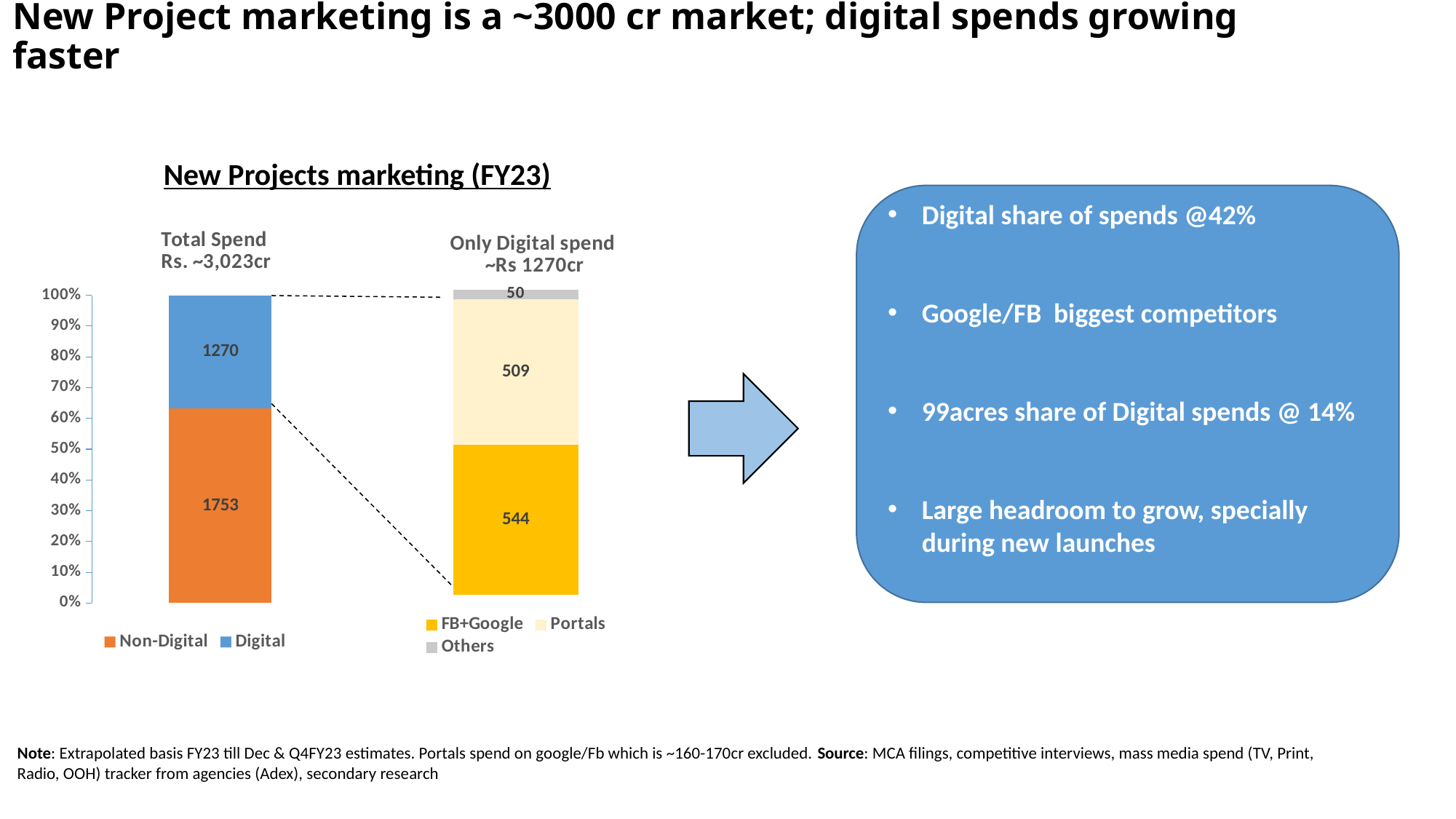
In the New Projects marketing (FY23) chart, what is the value labelled for Portals in the Only Digital spend bar? 509 In the New Projects marketing (FY23) chart, what is the value labelled for Others in the Only Digital spend bar? 50 In the New Projects marketing (FY23) chart, what is the total of the three segments in the Only Digital spend bar? 1103 In the New Projects marketing (FY23) chart, what is the difference between the Non-Digital and Digital values in the Total Spend bar? 483 In the New Projects marketing (FY23) chart, what is the value labelled for Non-Digital in the Total Spend bar? 1753 In the New Projects marketing (FY23) chart, which is larger in the Total Spend bar: Non-Digital or Digital? Non-Digital In the New Projects marketing (FY23) chart, which segment of the Only Digital spend bar has the largest value? FB+Google In the New Projects marketing (FY23) chart, what is the value labelled for FB+Google in the Only Digital spend bar? 544 In the New Projects marketing (FY23) chart, which segment of the Only Digital spend bar has the smallest value? Others In the New Projects marketing (FY23) chart, what is the value labelled for Digital in the Total Spend bar? 1270 What kind of chart is the New Projects marketing (FY23) chart? Stacked bar chart In the New Projects marketing (FY23) chart, how many entries does the legend for the Only Digital spend bar list? 3